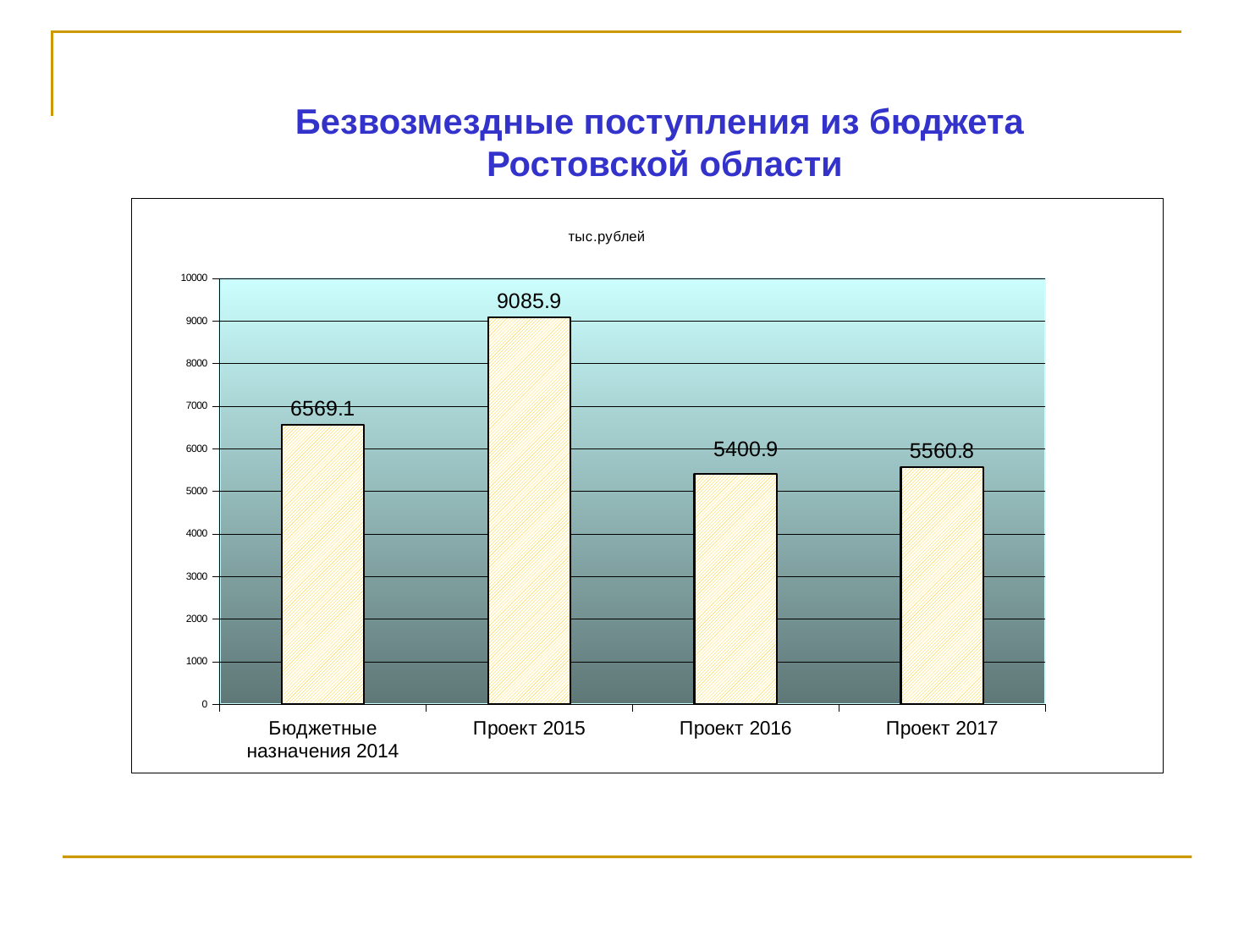
How many categories are shown on the chart? 4 What is the value for Проект 2016? 5400.9 What is the value for Проект 2017? 5560.8 What kind of chart is shown on the slide? Bar chart Which category has the highest value? Проект 2015 Which category has the lowest value? Проект 2016 What unit is indicated above the chart? тыс.рублей What is the difference between the values for Проект 2015 and Бюджетные назначения 2014? 2516.8 What is the value for Бюджетные назначения 2014? 6569.1 Which is larger, the value for Бюджетные назначения 2014 or the value for Проект 2017? Бюджетные назначения 2014 What is the difference between the values for Проект 2017 and Проект 2016? 159.9 What is the value for Проект 2015? 9085.9